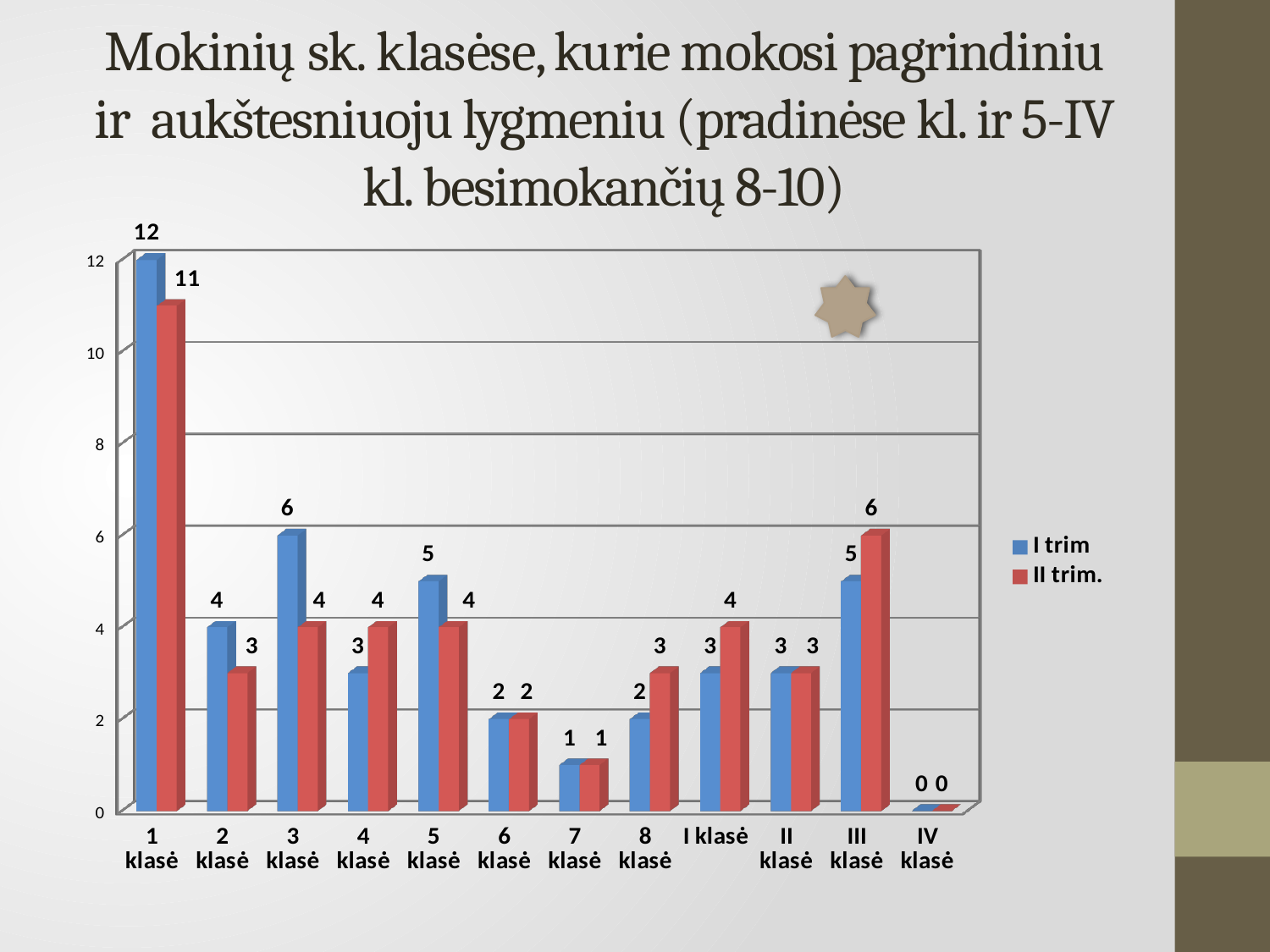
What kind of chart is shown on the slide? bar chart Which is larger in 5 klasė, I trim or II trim.? I trim What is the difference between I trim and II trim. in 1 klasė? 1 What is the value for I trim in 1 klasė? 12 How many categories are shown on the x axis? 12 Which category has the highest value for II trim.? 1 klasė What is the value for II trim. in 3 klasė? 4 Which category has the lowest value for I trim? IV klasė Which is larger in III klasė, I trim or II trim.? II trim. How many series does the legend list? 2 What is the value for II trim. in I klasė? 4 What colour are the II trim. bars? red